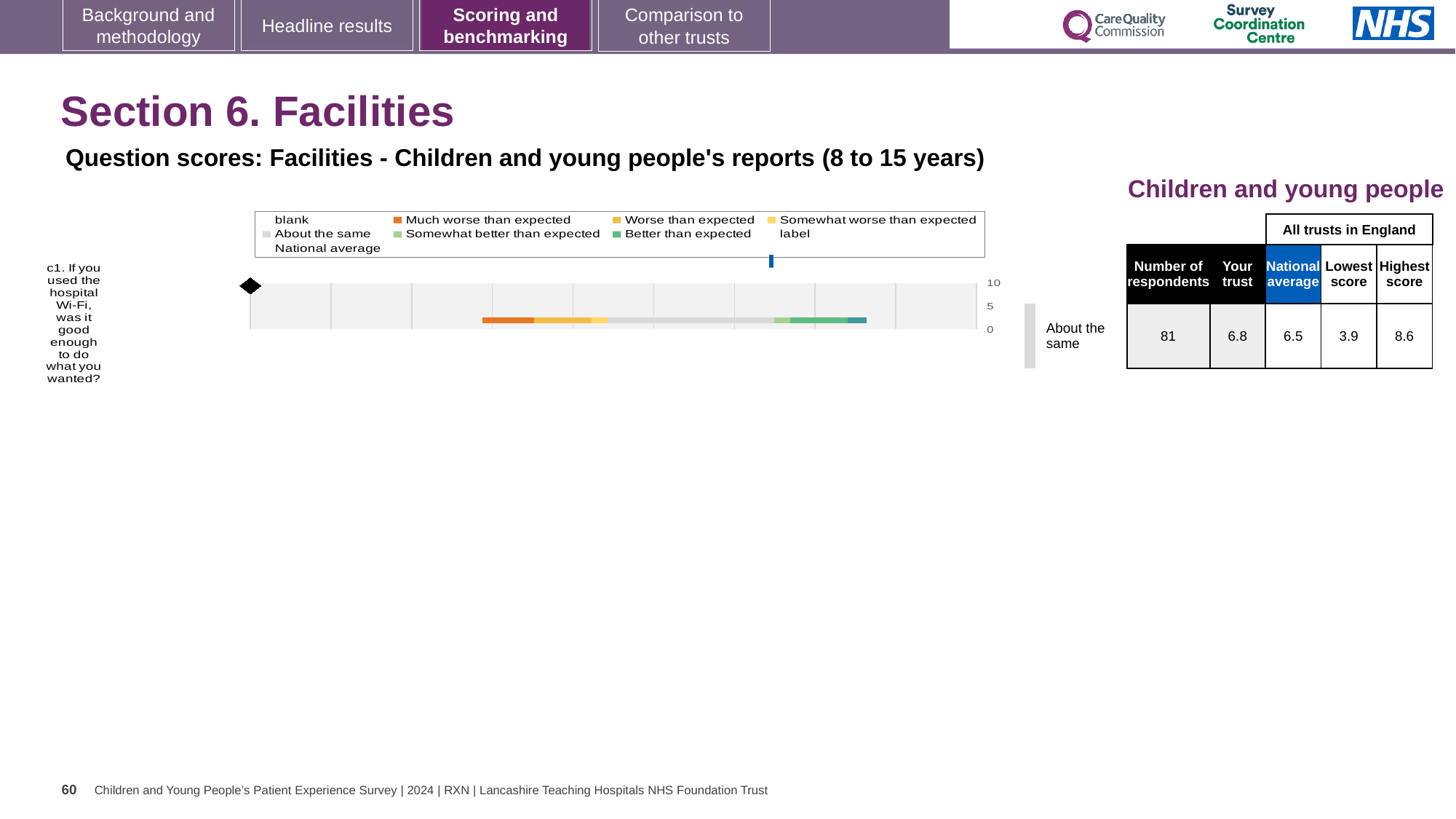
Which legend entry is shown in orange? Much worse than expected How many questions (categories) are plotted in the chart? 1 What is the highest value shown on the chart's axis? 10 What is the difference between the highest score and the lowest score for question c1? 4.7 What is the highest score among all trusts in England for question c1? 8.6 What is the national average score for question c1 about the hospital Wi-Fi? 6.5 How many respondents answered question c1 about the hospital Wi-Fi? 81 What kind of chart is shown on the slide? bar chart What is the 'Your trust' score for question c1 about the hospital Wi-Fi? 6.8 Which is larger for question c1: the 'Your trust' score or the national average? Your trust What benchmark rating is given to the trust for question c1 about the hospital Wi-Fi? About the same What is the lowest score among all trusts in England for question c1? 3.9